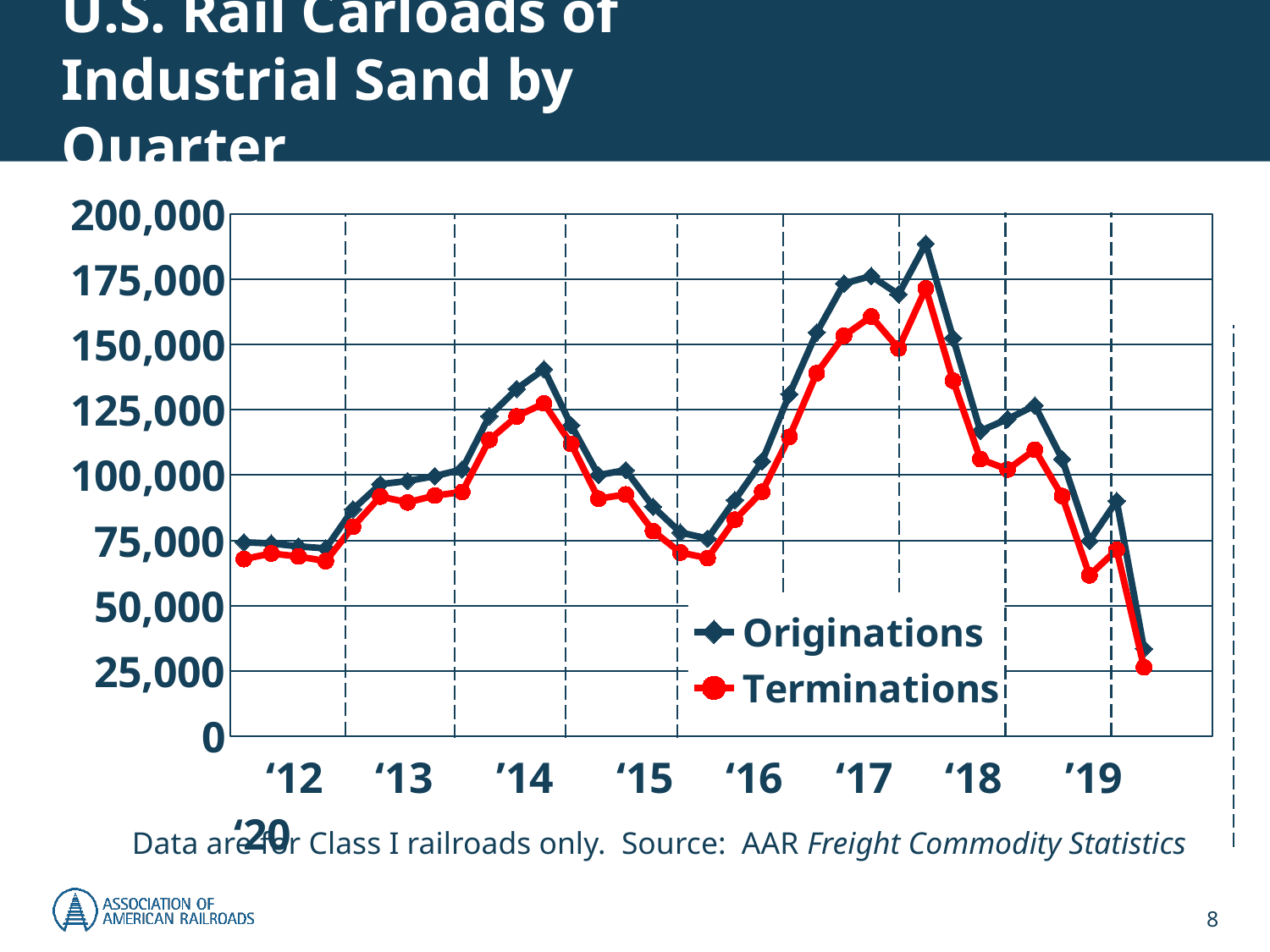
Which series is generally higher across the chart, Originations or Terminations? Originations Which series is plotted in red? Terminations Is the value for Originations in the first quarter of 2012 greater or less than 100,000? less Is the final plotted value for Originations in 2020 greater or less than 50,000? less What are the two series named in the legend? Originations and Terminations Which is higher for Originations: the peak in 2014 or the peak in 2017? the peak in 2017 Do the values for both series rise or fall from the 2017 peak to the end of the chart in 2020? fall Is the peak value for Originations in 2014 greater or less than 125,000? greater What kind of chart is shown on the slide? line chart How many series does the legend list? 2